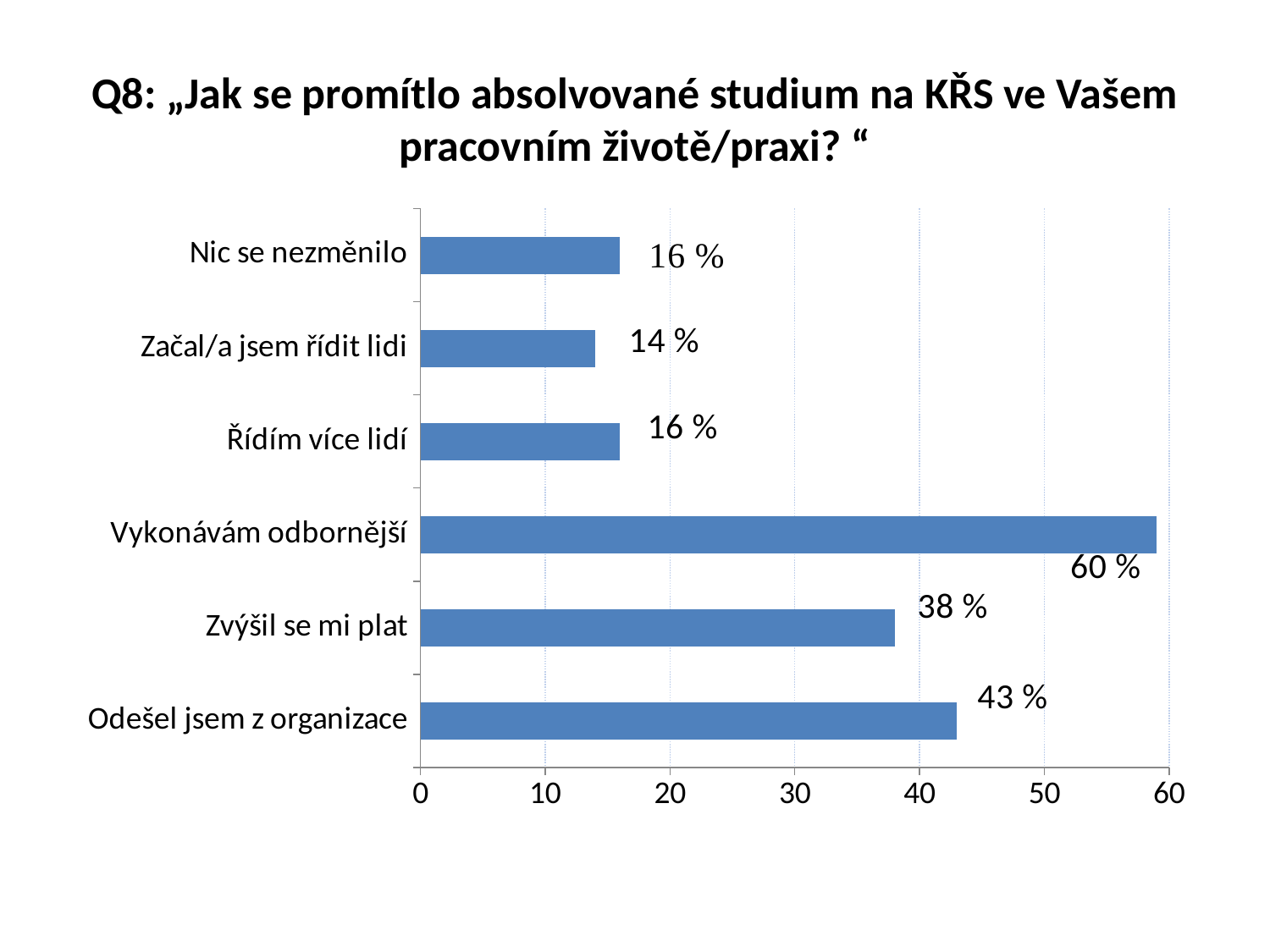
What is the value for "Vykonávám odbornější"? 60 % Which is larger, the value for "Zvýšil se mi plat" or the value for "Odešel jsem z organizace"? Odešel jsem z organizace What is the highest value shown on the horizontal axis? 60 What is the difference between the values for "Odešel jsem z organizace" and "Zvýšil se mi plat"? 5 % What is the value for "Zvýšil se mi plat"? 38 % Which category has the lowest value? Začal/a jsem řídit lidi What kind of chart is shown on the slide? bar chart Is the value for "Zvýšil se mi plat" greater or less than 30? greater Which category has the highest value? Vykonávám odbornější What is the value for "Začal/a jsem řídit lidi"? 14 % What is the value for "Odešel jsem z organizace"? 43 % How many categories does the chart show? 6